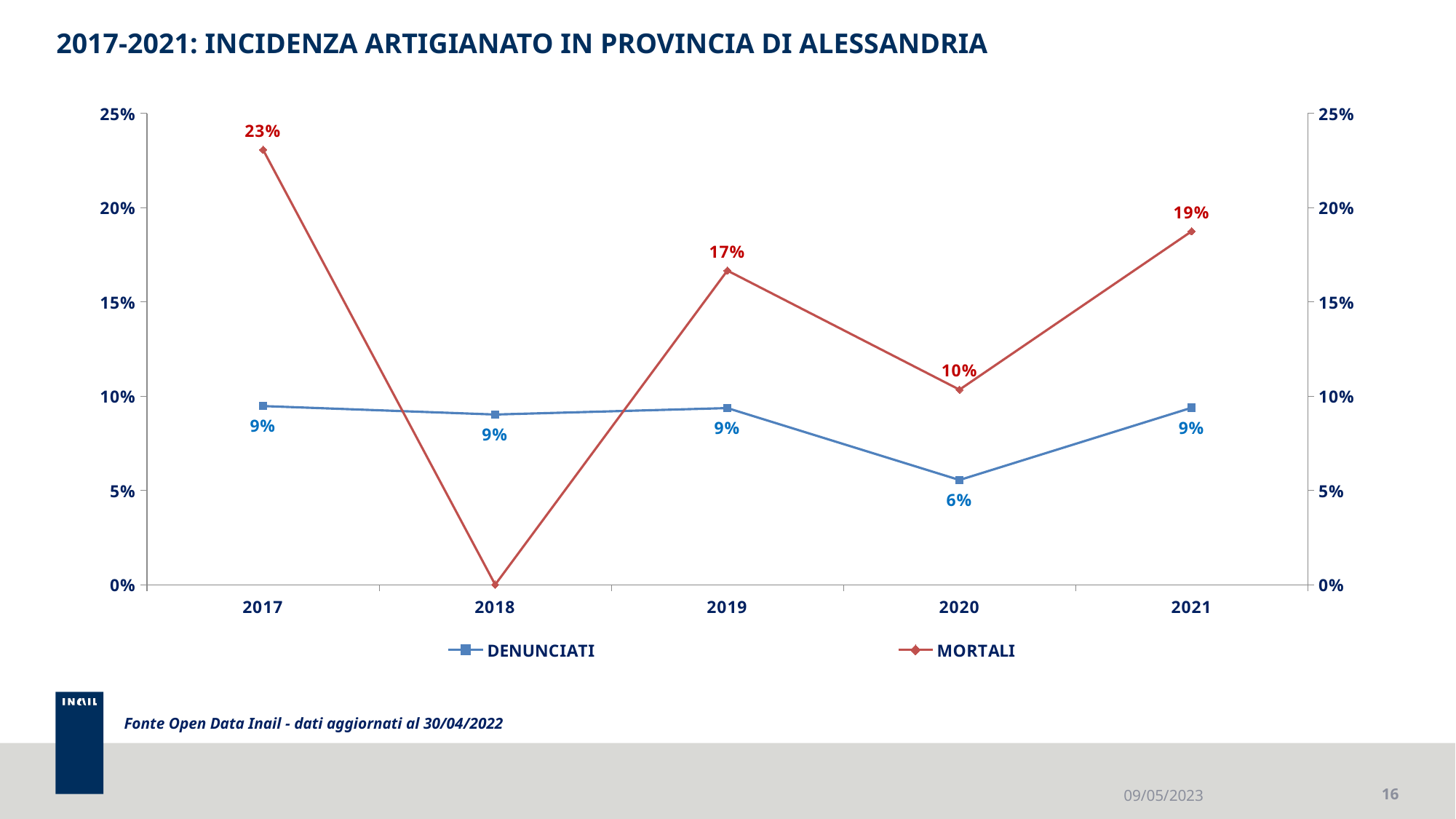
How many series does the legend list? 2 What is the MORTALI value for 2021? 19% What is the MORTALI value for 2017? 23% In which year is the DENUNCIATI series lowest? 2020 In which year is the MORTALI series highest? 2017 What kind of chart is shown on the slide? line chart Which is larger in 2020, the MORTALI value or the DENUNCIATI value? MORTALI What is the difference between the MORTALI value in 2017 and the MORTALI value in 2019? 6% Does the MORTALI series rise or fall from 2020 to 2021? rise Is the MORTALI value for 2018 greater or less than 5%? less How many years are shown on the x axis? 5 What is the DENUNCIATI value for 2020? 6%